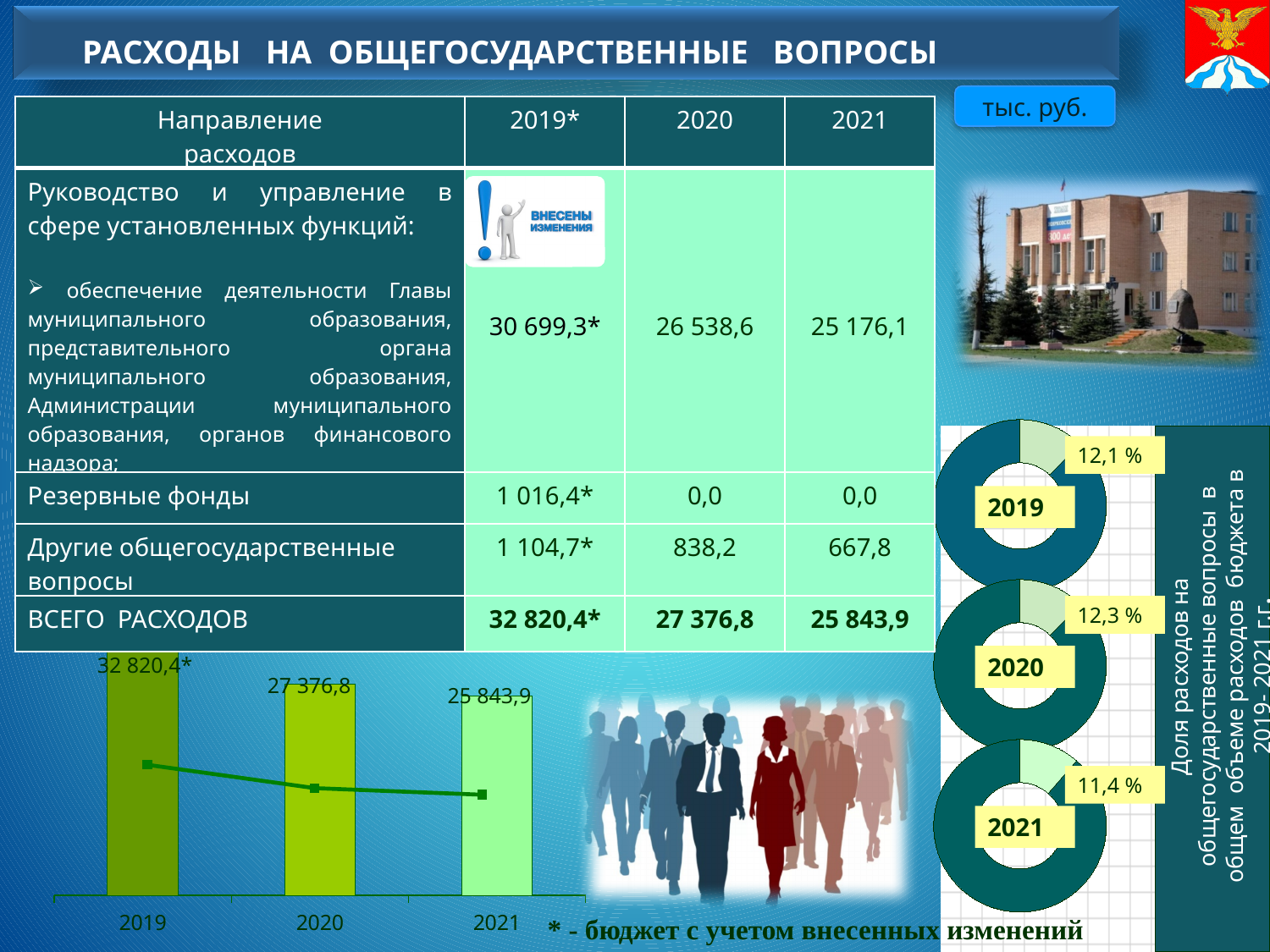
In the bar chart at the bottom left of the slide, which year has the lowest value? 2021 In the bar chart at the bottom left of the slide, do the values rise or fall from 2019 to 2021? fall What kind of chart is shown at the bottom left of the slide? bar chart In the bar chart at the bottom left of the slide, how many years are shown on the x axis? 3 In the bar chart at the bottom left of the slide, what is the value for 2019? 32 820,4* In the donut charts on the right of the slide, which is larger, the share for 2019 or for 2021? 2019 In the donut charts on the right of the slide, which year has the lowest share? 2021 In the donut charts on the right of the slide, what share is shown for 2020? 12,3 % In the bar chart at the bottom left of the slide, what is the value for 2021? 25 843,9 In the donut charts on the right of the slide, what is the difference between the 2020 and 2021 shares? 0,9 % In the bar chart at the bottom left of the slide, which year has the highest value? 2019 In the bar chart at the bottom left of the slide, what is the difference between the 2020 and 2021 values? 1 532,9